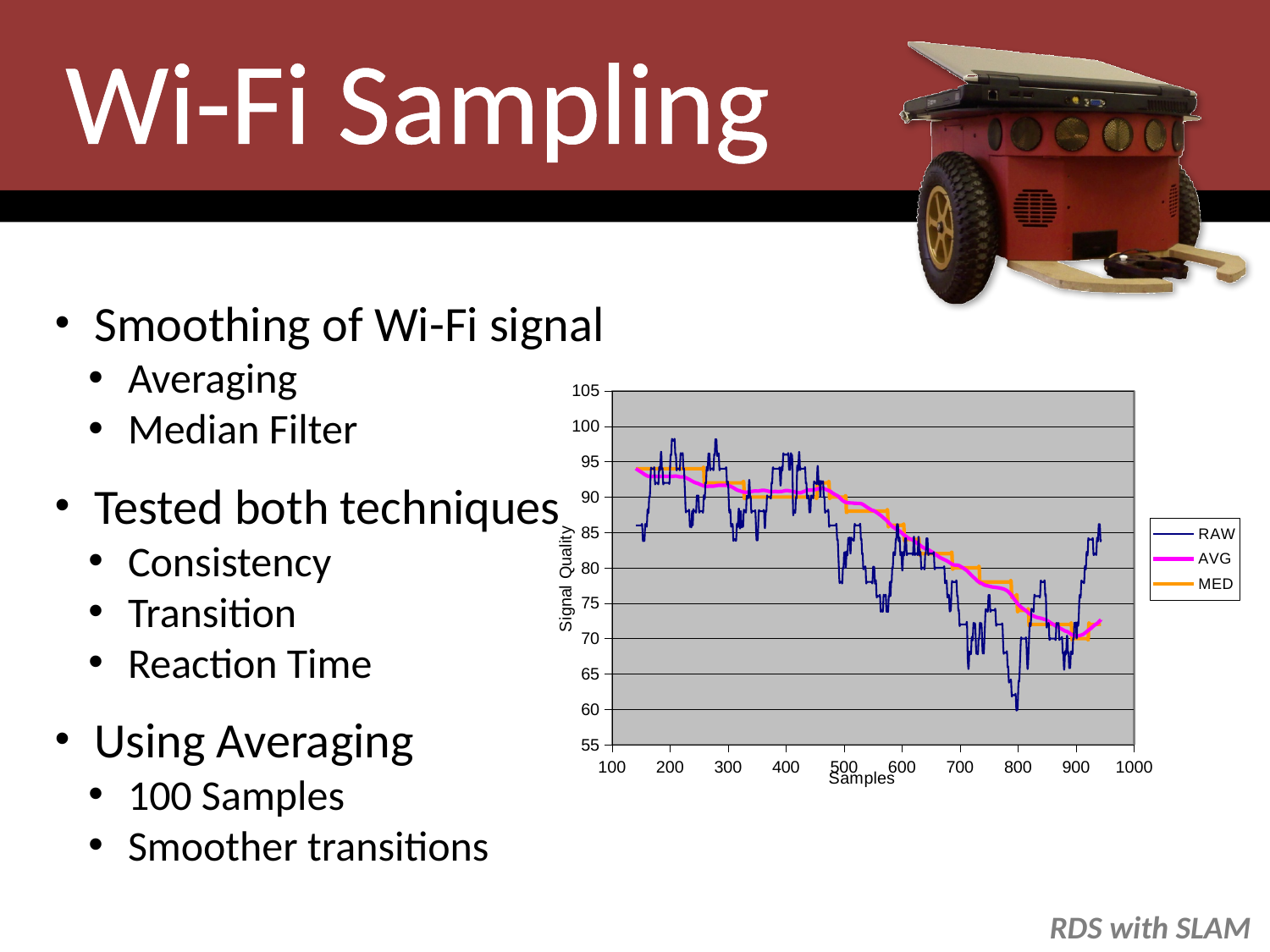
Is the lowest RAW value near 800 samples greater or less than 65? less Which is larger, the AVG value at 200 samples or the AVG value at 900 samples? AVG at 200 samples What are the series names listed in the chart's legend? RAW, AVG, MED Is the AVG value at 200 samples greater or less than 90? greater Is the AVG value at 400 samples greater or less than 85? greater How many series does the chart's legend list? 3 Overall, do the signal quality values rise or fall as the number of samples increases along the x axis? fall What kind of chart is shown on the slide? line chart What is the label of the chart's vertical axis? Signal Quality